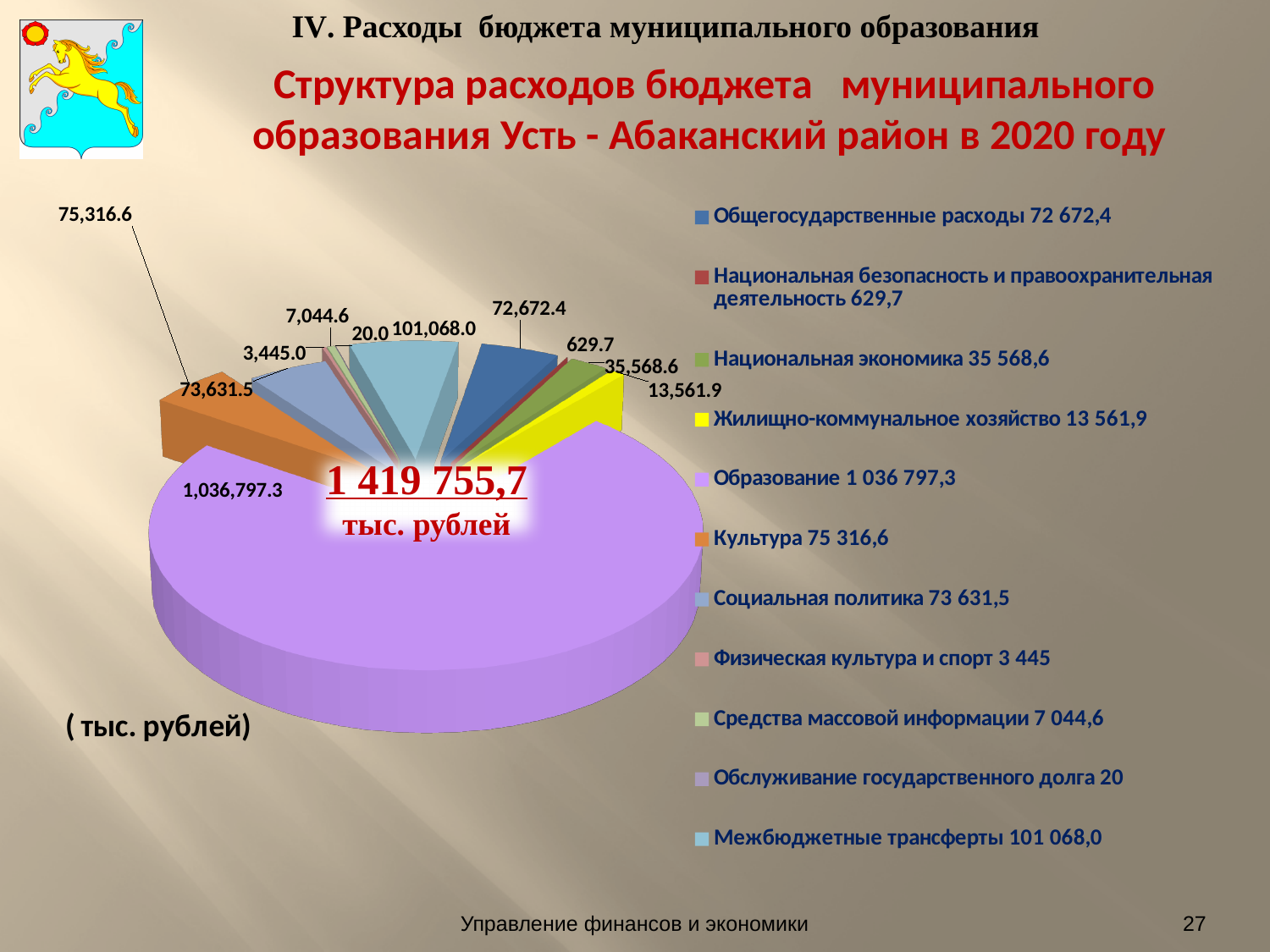
What is the value for Межбюджетные трансферты in the pie chart? 101,068.0 Which is larger: Национальная экономика or Общегосударственные расходы? Общегосударственные расходы What kind of chart is shown on the slide? Pie chart Which category has the smallest value in the pie chart? Обслуживание государственного долга What is the value for Жилищно-коммунальное хозяйство in the pie chart? 13,561.9 What is the difference between the values for Культура and Социальная политика? 1,685.1 In what units are the values of the pie chart given, according to the label below the chart? тыс. рублей What is the value for Обслуживание государственного долга in the pie chart? 20.0 What is the value for Образование in the pie chart? 1,036,797.3 Which category has the largest slice in the pie chart? Образование How many categories (slices) does the pie chart have? 11 What total amount is shown in the centre of the pie chart? 1 419 755,7 тыс. рублей